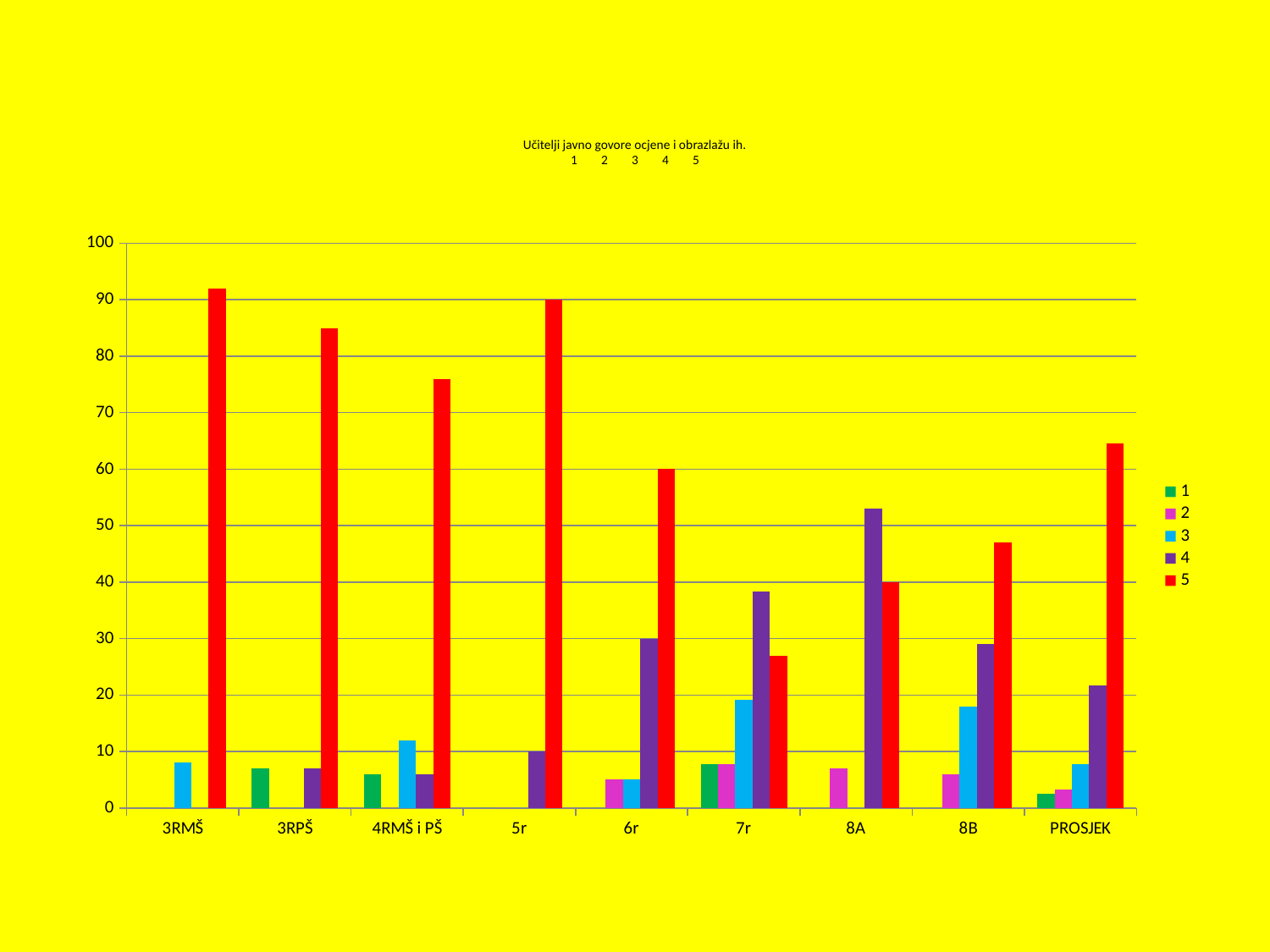
How many categories are shown on the x axis? 9 For 8A, which is larger: the bar for series 4 or the bar for series 5? series 4 How many series does the legend list? 5 Which category has the lowest bar for series 5? 7r What is the title of the chart? Učitelji javno govore ocjene i obrazlažu ih. Which category has the highest bar for series 4? 8A Is the value for series 5 at 8B greater or less than 50? less What kind of chart is shown on the slide? bar chart For 7r, which is larger: the bar for series 4 or the bar for series 5? series 4 Is the value for series 5 at 4RMŠ i PŠ greater or less than 70? greater Is the value for series 5 at PROSJEK greater or less than 60? greater